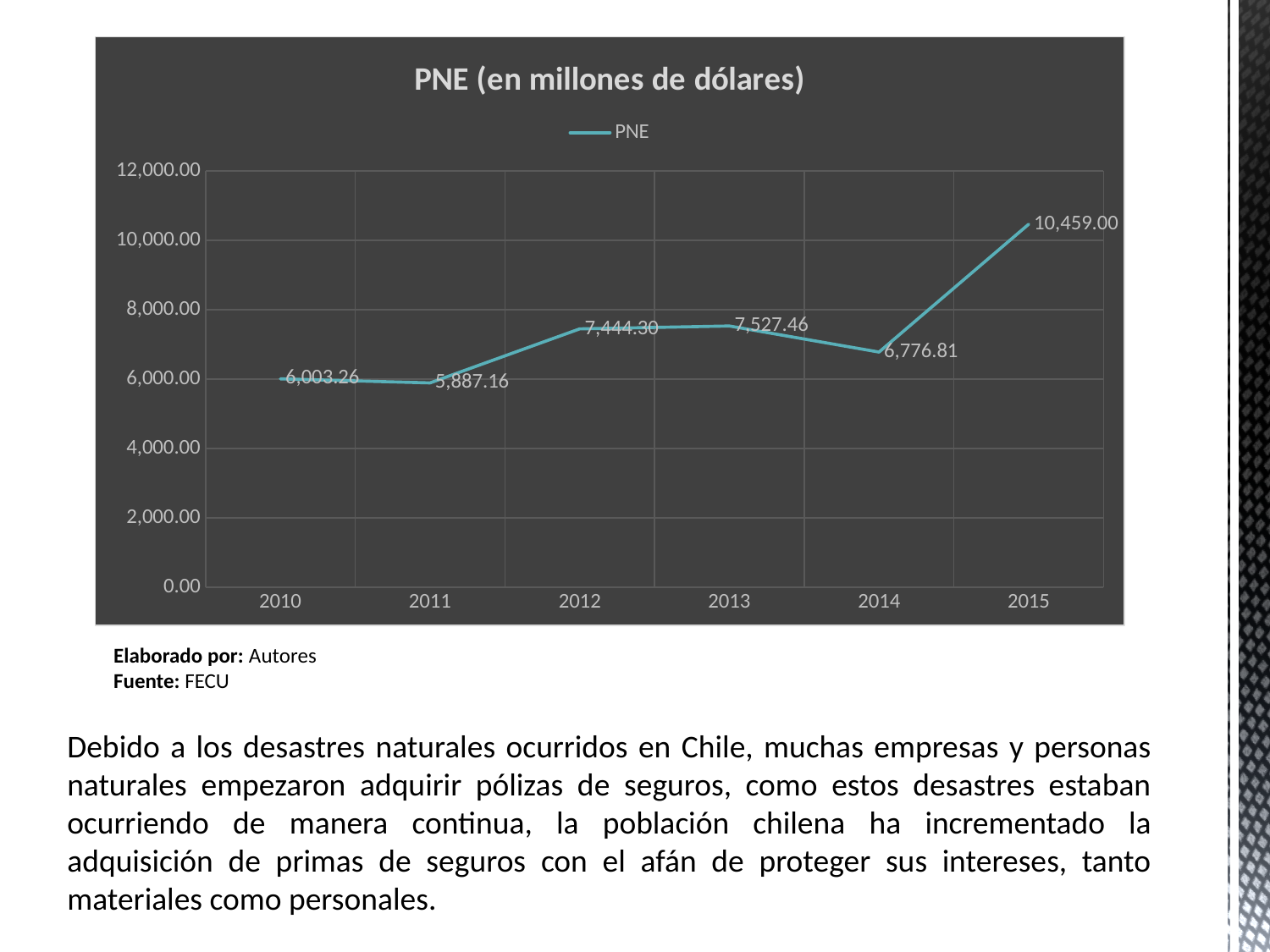
Which year has the lowest PNE value? 2011 What is the PNE value for 2014? 6,776.81 What is the difference between the PNE values for 2013 and 2012? 83.16 What kind of chart is shown on the slide? line chart What is the title of the chart? PNE (en millones de dólares) Which year has a larger PNE value, 2010 or 2014? 2014 Which year has the highest PNE value? 2015 What is the PNE value for 2011? 5,887.16 What is the difference between the PNE values for 2015 and 2014? 3,682.19 Is the PNE value for 2015 greater or less than 10,000.00? greater What is the PNE value for 2015? 10,459.00 How many years are plotted on the chart? 6